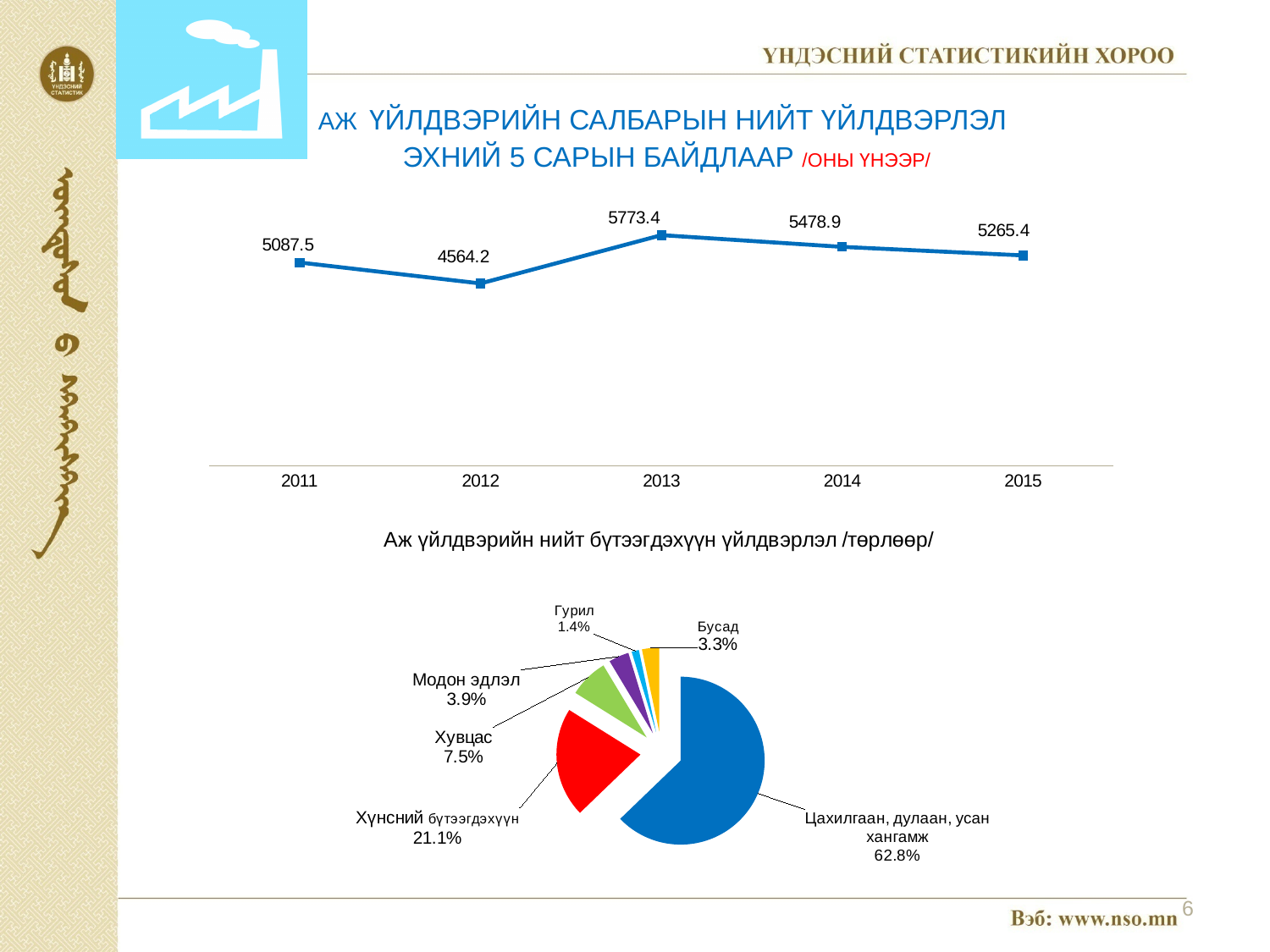
In the top line chart, how many years are plotted? 5 In the top line chart, which year has the highest value? 2013 In the pie chart 'Аж үйлдвэрийн нийт бүтээгдэхүүн үйлдвэрлэл /төрлөөр/', what share does 'Хүнсний бүтээгдэхүүн' have? 21.1% In the top line chart, what is the difference between the 2013 value and the 2012 value? 1209.2 In the pie chart 'Аж үйлдвэрийн нийт бүтээгдэхүүн үйлдвэрлэл /төрлөөр/', which category has the largest slice? Цахилгаан, дулаан, усан хангамж In the top line chart, which is larger, the value for 2014 or the value for 2015? 2014 In the top line chart, what is the value for 2011? 5087.5 In the pie chart 'Аж үйлдвэрийн нийт бүтээгдэхүүн үйлдвэрлэл /төрлөөр/', how many slices are there? 6 In the top line chart, which year has the lowest value? 2012 What kind of chart is the top chart on the slide? line chart In the top line chart, do the values rise or fall from 2013 to 2015? fall In the top line chart, what is the value for 2013? 5773.4